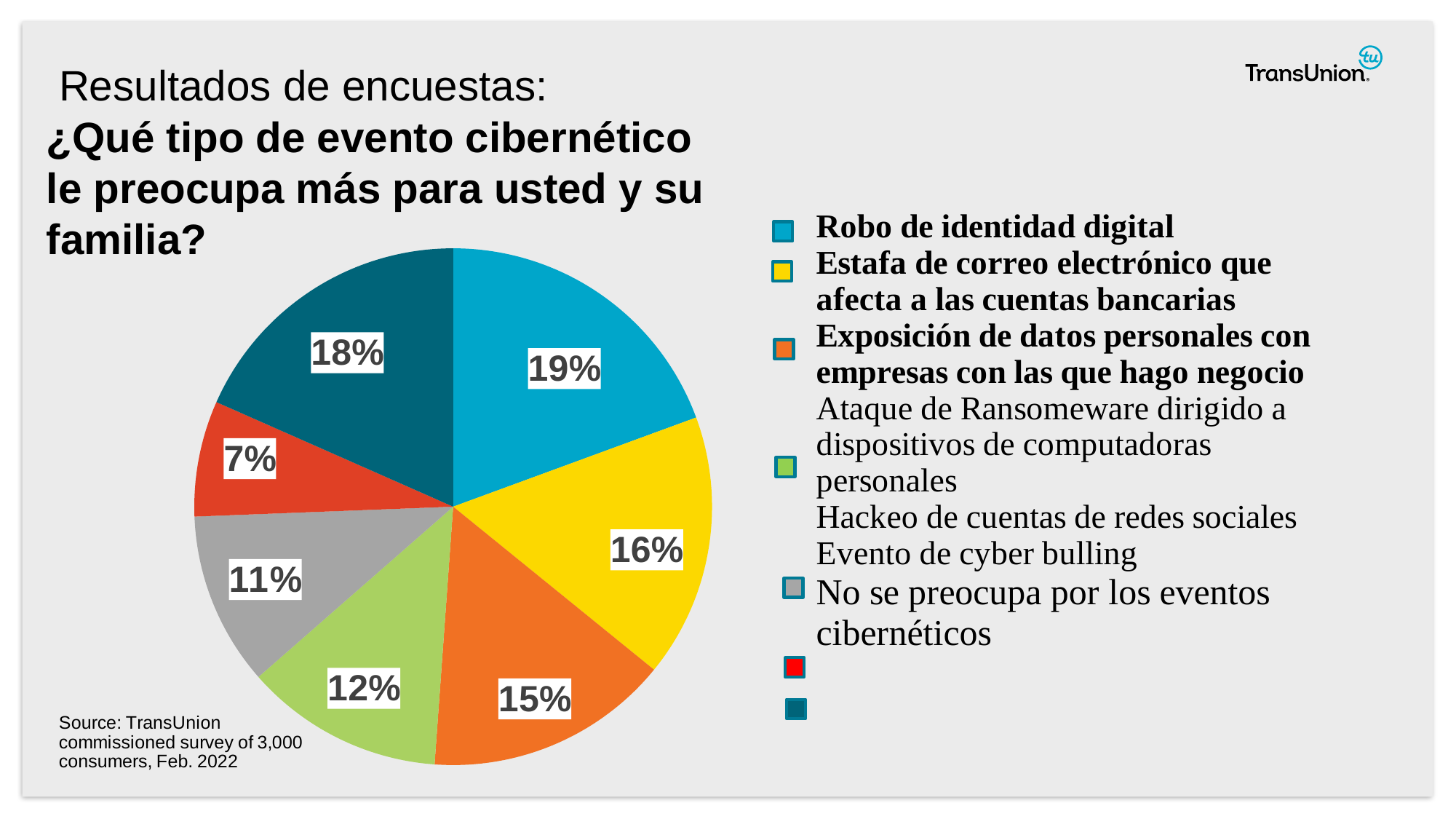
What percentage is shown for "Exposición de datos personales con empresas con las que hago negocio"? 15% According to the source note, how many consumers were surveyed? 3,000 What percentage of the pie is labelled for "Robo de identidad digital"? 19% What is the smallest percentage labelled on the pie chart? 7% What percentage is shown for "Estafa de correo electrónico que afecta a las cuentas bancarias"? 16% What percentage is labelled on the dark teal slice of the pie? 18% Which legend category has the largest slice of the pie? Robo de identidad digital How many slices does the pie chart have? 7 What kind of chart is shown on the slide? pie chart By how many percentage points does "Robo de identidad digital" exceed "Estafa de correo electrónico que afecta a las cuentas bancarias"? 3 percentage points Which is larger: the slice for "Robo de identidad digital" or the slice for "Exposición de datos personales con empresas con las que hago negocio"? Robo de identidad digital What percentage is labelled on the light green slice of the pie? 12%